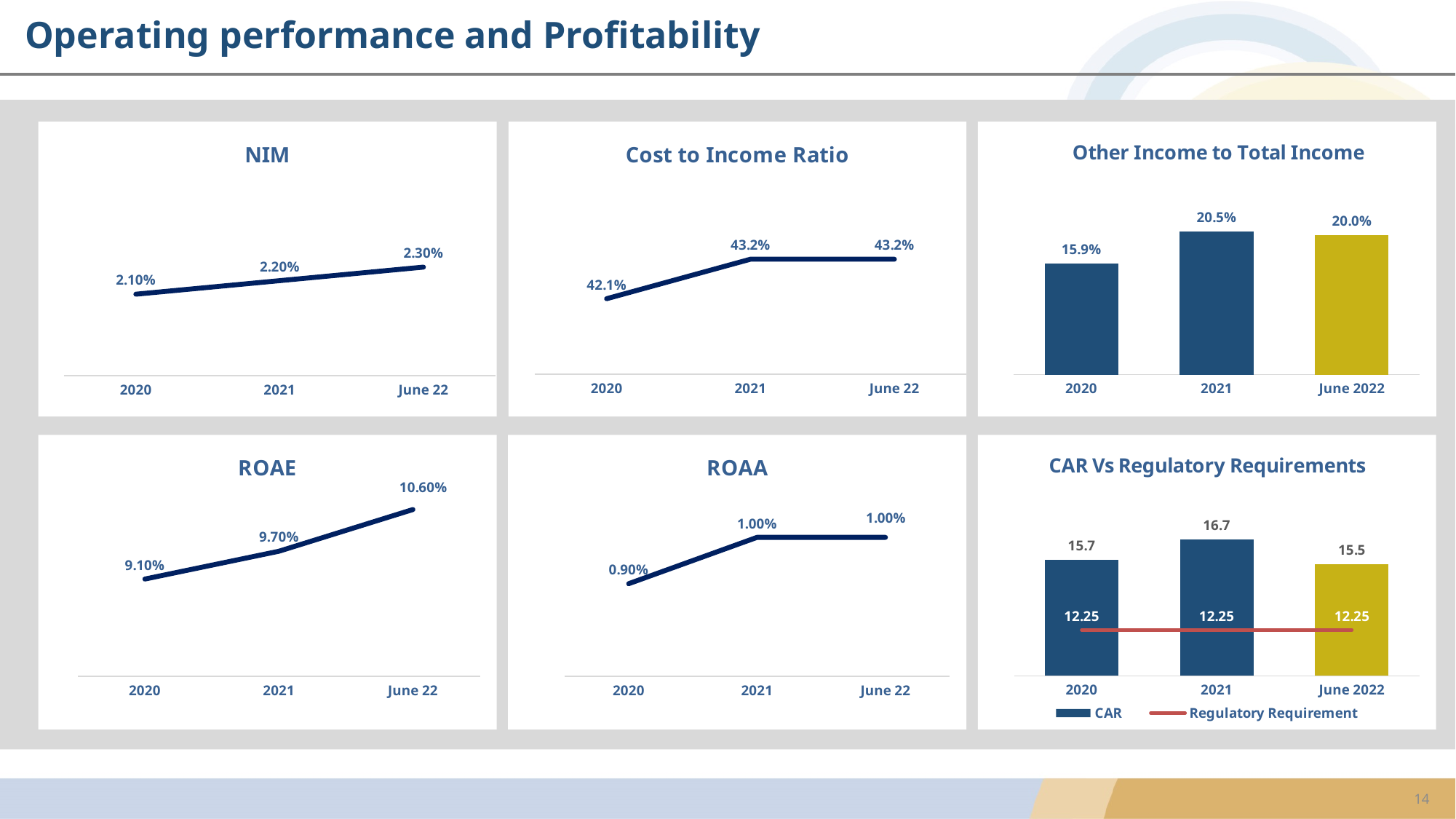
In the Other Income to Total Income chart, what is the value for 2020? 15.9% How many series does the legend of the CAR Vs Regulatory Requirements chart list? 2 In the ROAE chart, what is the difference between the June 22 value and the 2020 value? 1.50% In the Cost to Income Ratio chart, what is the value for 2020? 42.1% In the Other Income to Total Income chart, which year has the highest value? 2021 In the ROAA chart, which is larger, the value for 2020 or the value for 2021? 2021 In the NIM chart, do the values rise or fall from 2020 to June 22? rise What kind of chart is the Other Income to Total Income chart? bar chart In the CAR Vs Regulatory Requirements chart, what is the CAR value for 2021? 16.7 In the Cost to Income Ratio chart, what is the difference between the 2021 value and the 2020 value? 1.1% In the NIM chart, what is the value for June 22? 2.30% In the ROAE chart, what is the value for June 22? 10.60%